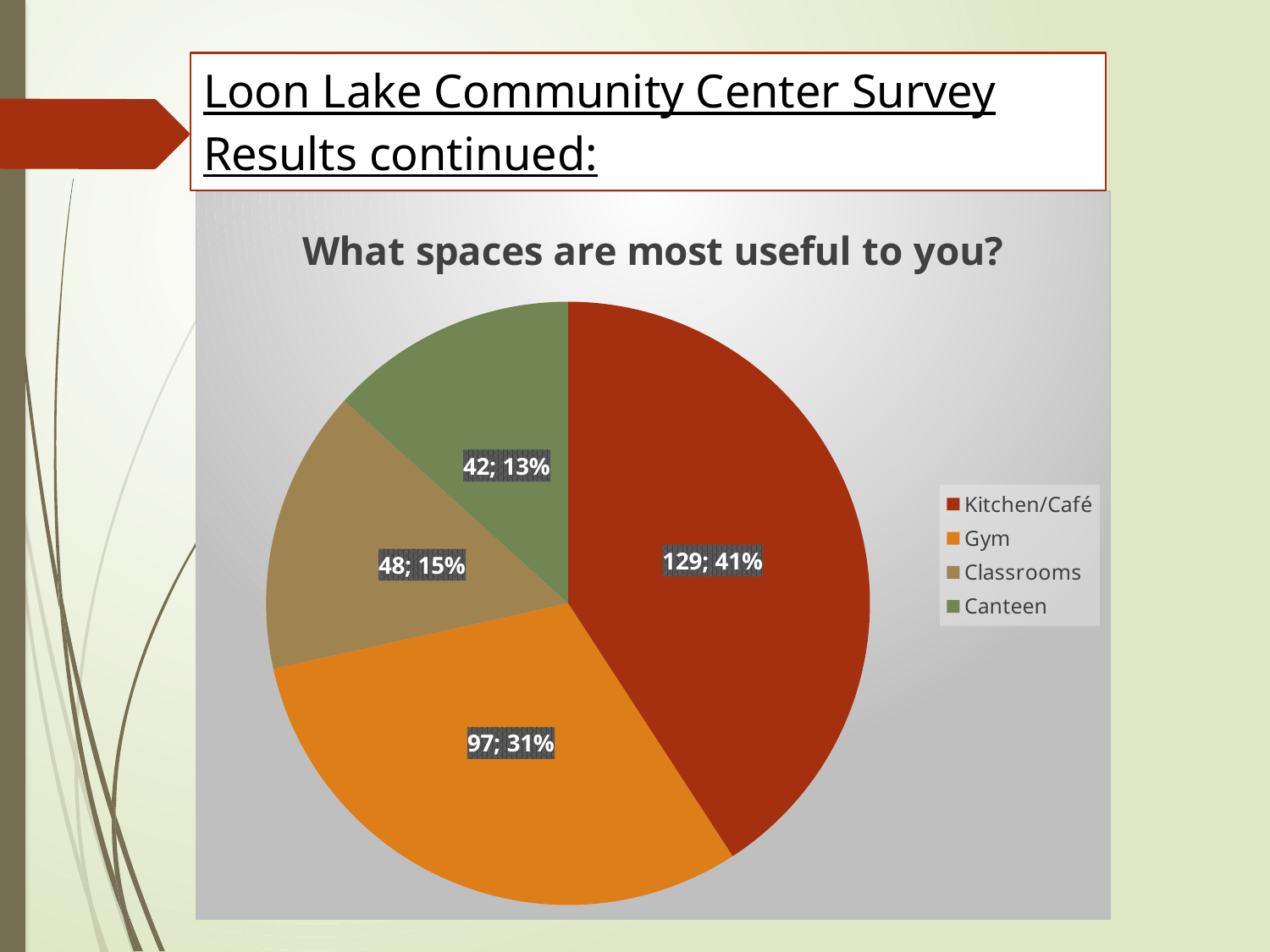
What is the value for Kitchen/Café? 129 Which category has the smallest slice? Canteen What is the title of the chart? What spaces are most useful to you? What is the value for Gym? 97 What share of the pie does Kitchen/Café represent? 41% Which category has the largest slice? Kitchen/Café What kind of chart is shown on the slide? pie chart How many entries does the legend list? 4 What is the difference between the values for Kitchen/Café and Gym? 32 How many slices does the pie chart have? 4 What is the value for Classrooms? 48 What share of the pie does Canteen represent? 13%